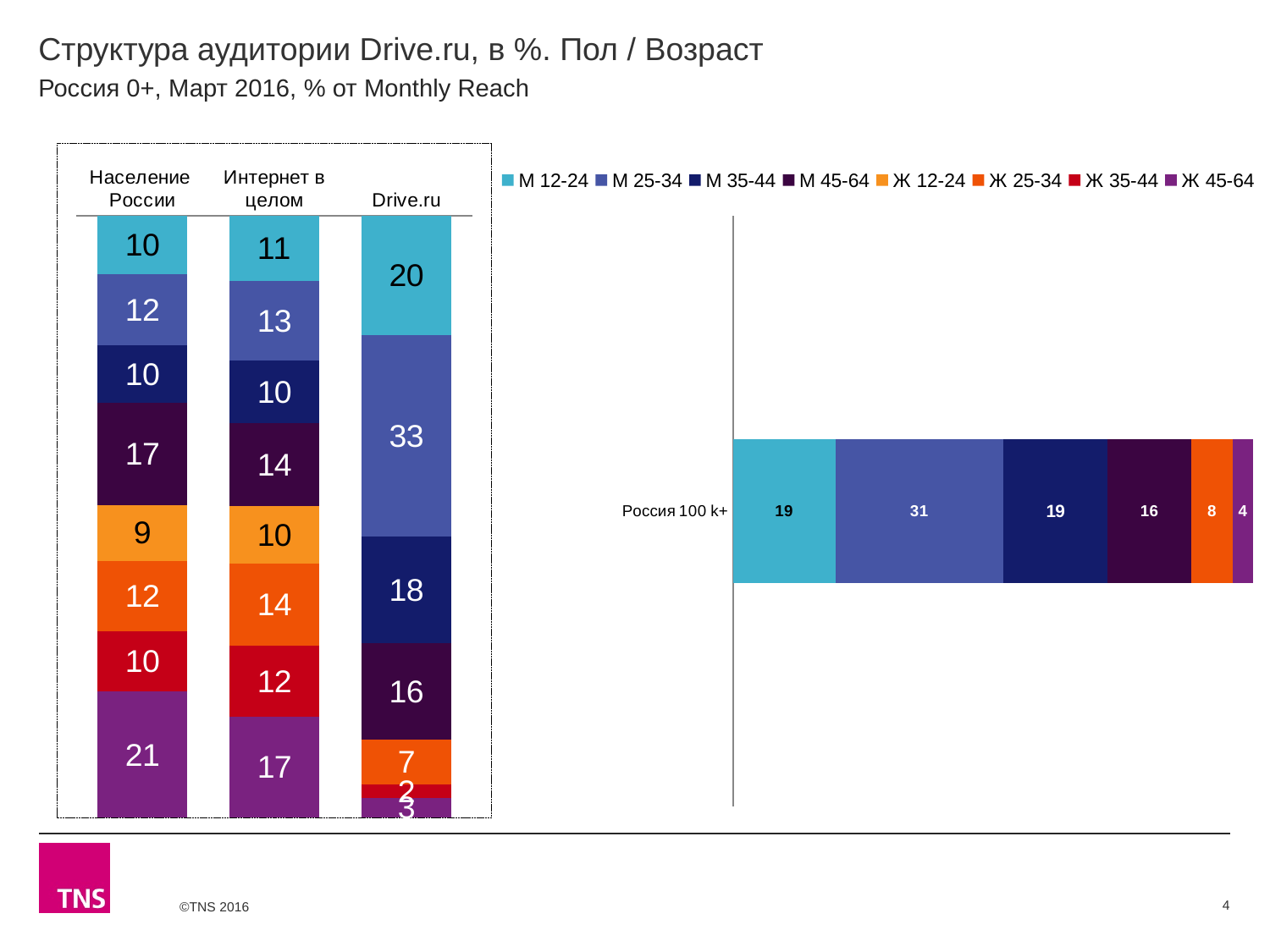
In the left chart, what is the value of the Ж 45-64 segment for Интернет в целом? 17 How many series does the legend list? 8 In the right chart (Россия 100 k+), what is the value of the М 25-34 segment? 31 In the left chart, which segment is the largest in the Drive.ru bar? М 25-34 In the right chart (Россия 100 k+), what is the value of the Ж 25-34 segment? 8 In the right chart (Россия 100 k+), which segment is the largest? М 25-34 In the left chart, what is the value of the М 25-34 segment for Drive.ru? 33 In the left chart, is the Ж 45-64 value larger for Население России or for Интернет в целом? Население России In the left chart, what is the difference between the М 12-24 value for Drive.ru and the М 12-24 value for Население России? 10 In the left chart, what is the value of the М 45-64 segment for Население России? 17 In the right chart (Россия 100 k+), what is the difference between the М 25-34 and М 45-64 values? 15 How many bars are shown in the left chart? 3